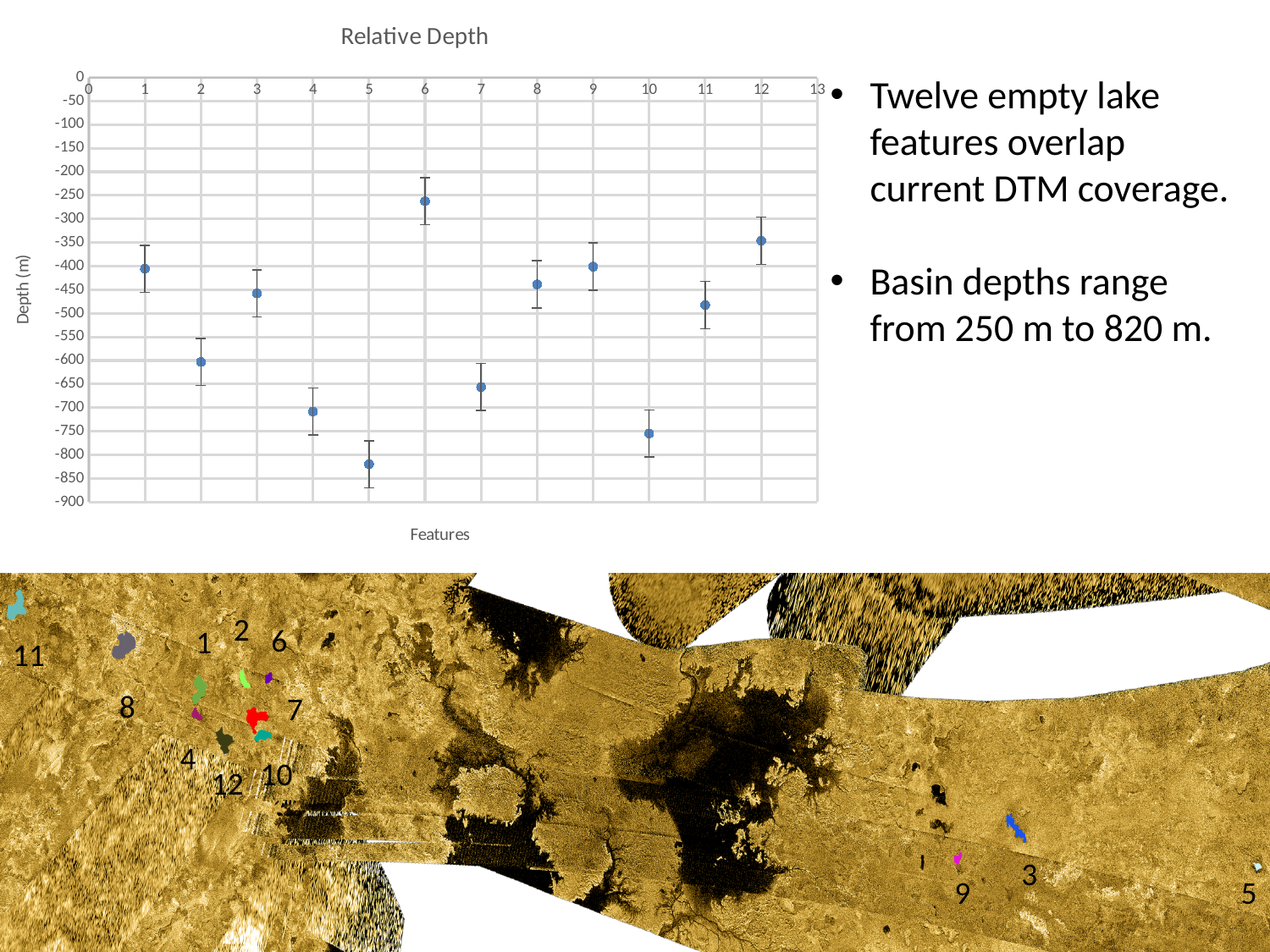
What kind of chart is shown on the slide? Scatter chart Is the value for feature 12 greater or less than -400? greater Is the value for feature 5 greater or less than -800? less What is the label of the vertical axis of the chart? Depth (m) Is the value for feature 6 greater or less than -300? greater Which has the larger (less negative) depth value, feature 1 or feature 2? Feature 1 Which has the larger (less negative) depth value, feature 7 or feature 8? Feature 8 What is the title of the chart? Relative Depth Which feature has the highest (least negative) depth value in the chart? Feature 6 Which feature has the lowest (most negative) depth value in the chart? Feature 5 How many data points are plotted in the chart? 12